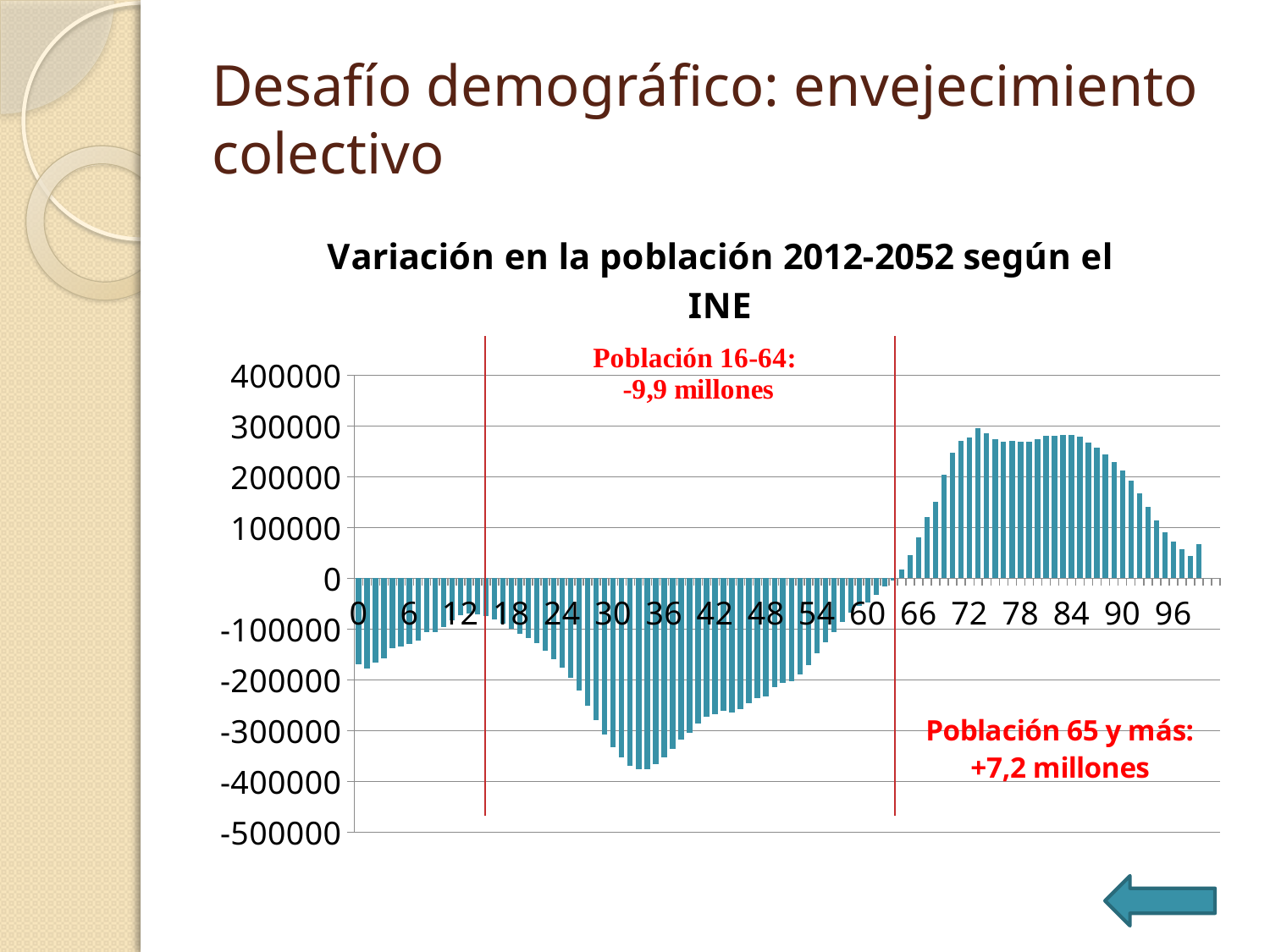
Is the value for age 0 greater or less than -100000? less Which has the larger value, age 6 or age 30? age 6 Is the value for age 96 greater or less than 100000? less Which has the larger value, age 72 or age 36? age 72 Do the values rise or fall from age 36 to age 60? rise According to the annotation on the chart, what is the change for Población 65 y más? +7,2 millones Is the value for age 48 greater or less than 0? less What is the title of the chart? Variación en la población 2012-2052 según el INE What kind of chart is shown on the slide? bar chart Do the values rise or fall from age 84 to age 96? fall